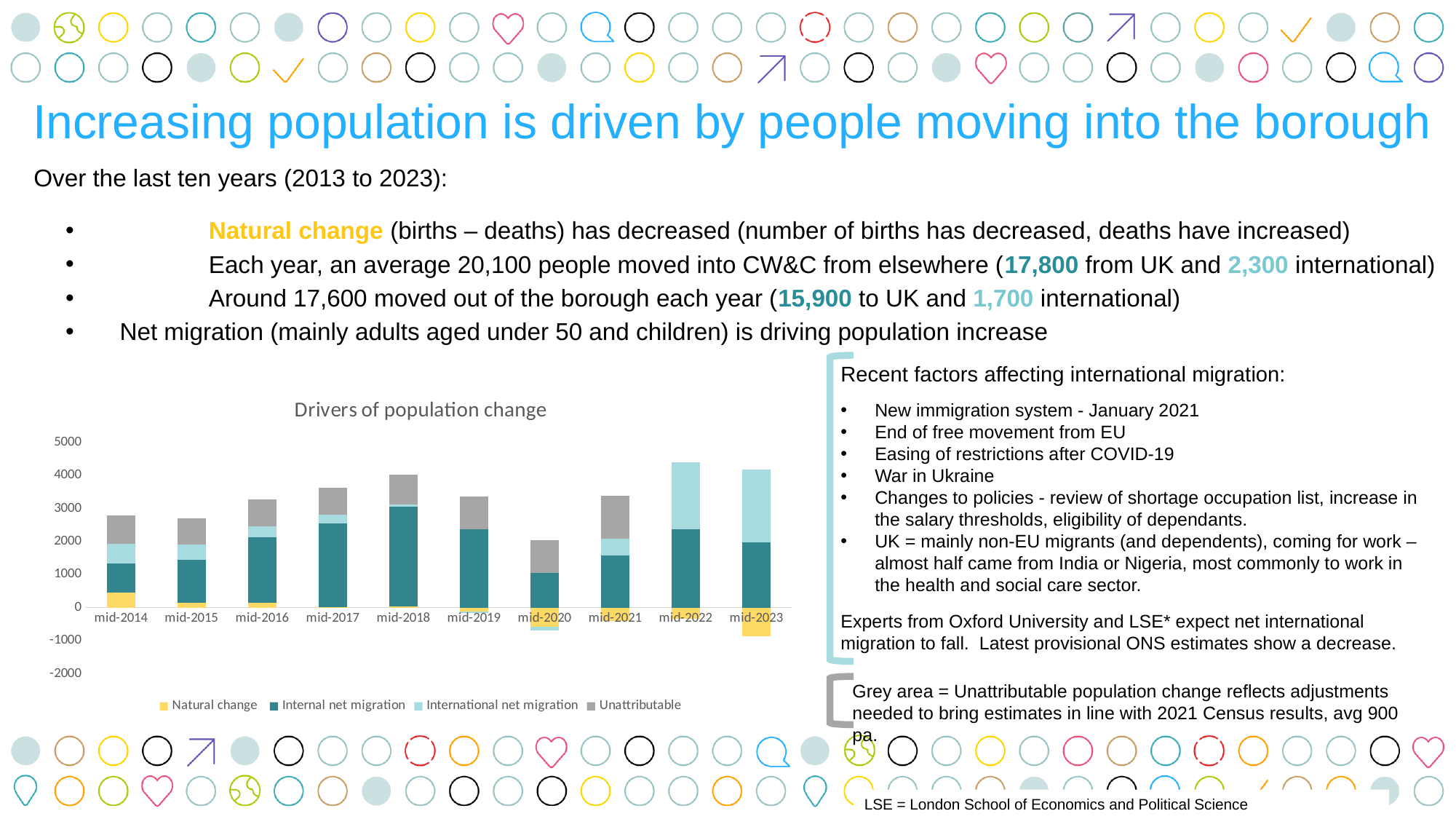
In the 'Drivers of population change' chart, is the Natural change value for mid-2023 greater or less than 0? less In the 'Drivers of population change' chart, which period has the lowest total bar? mid-2020 How many time periods are shown on the x axis of the 'Drivers of population change' chart? 10 In the 'Drivers of population change' chart, is the Internal net migration value for mid-2018 greater or less than 2000? greater In the 'Drivers of population change' chart, is the total bar for mid-2022 greater or less than 4000? greater What kind of chart is 'Drivers of population change'? stacked bar chart Which series in the 'Drivers of population change' chart is shown in grey? Unattributable How many series does the legend of the 'Drivers of population change' chart list? 4 In the 'Drivers of population change' chart, which has the larger total bar, mid-2018 or mid-2020? mid-2018 What is the title of the chart on the slide? Drivers of population change